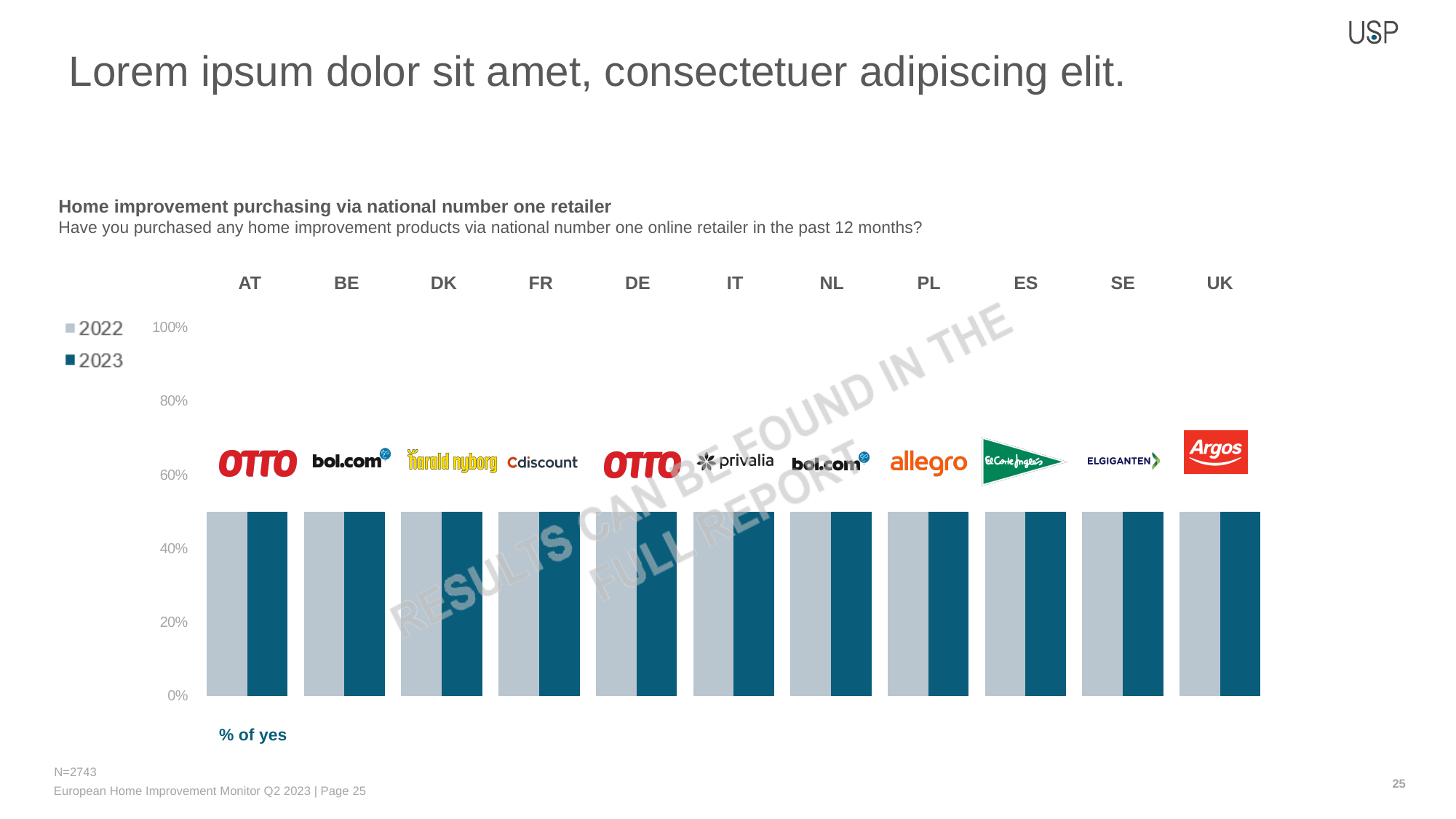
What are the two series listed in the chart legend? 2022 and 2023 Is the 2022 value for AT greater or less than 20%? greater Is the 2022 value for SE greater or less than 80%? less Is the 2022 value for PL greater or less than 40%? greater How many countries are shown along the x axis of the chart? 11 What kind of chart is shown on the slide? bar chart How many series does the chart legend list? 2 What is the title of the chart? Home improvement purchasing via national number one retailer